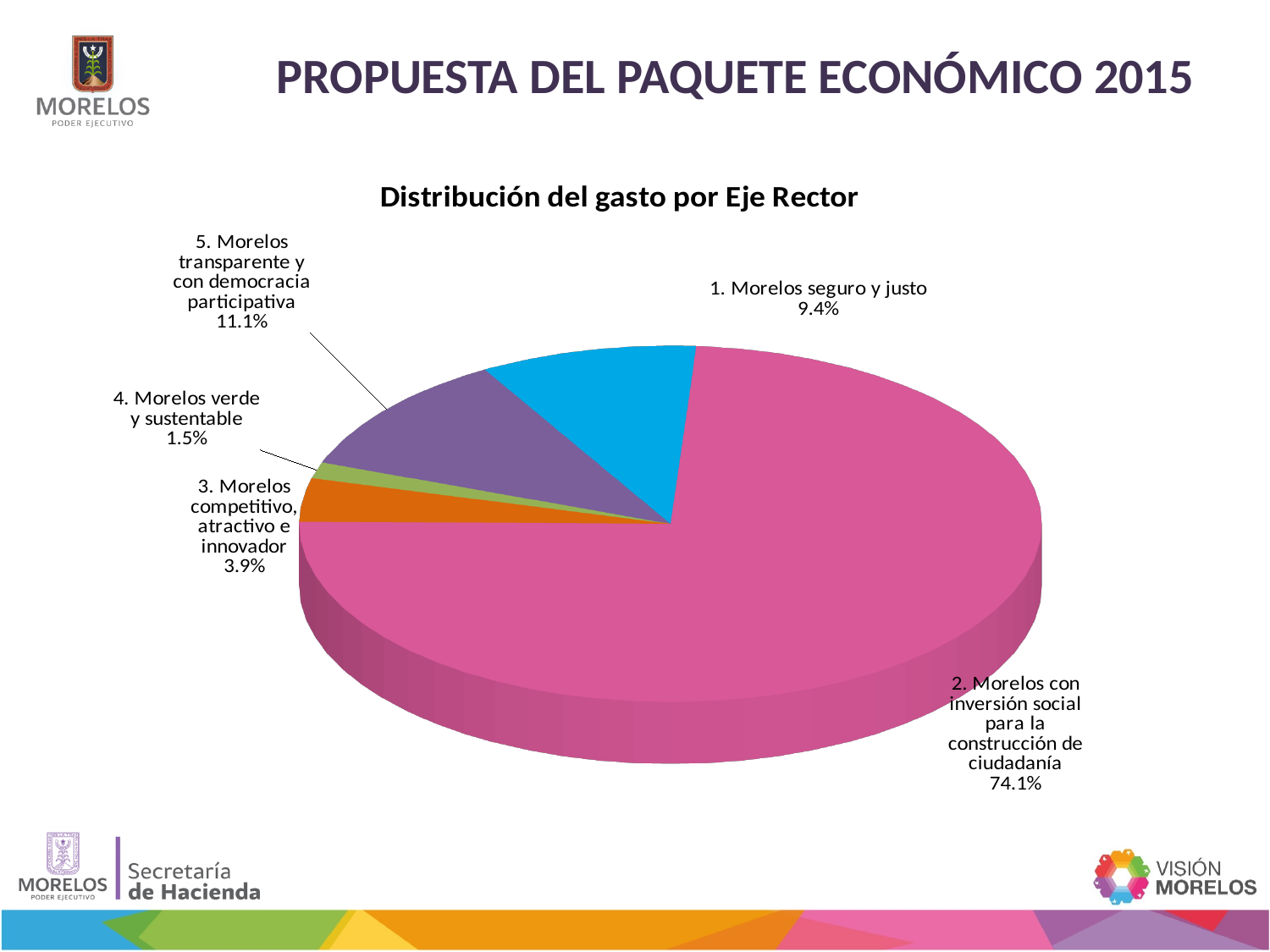
How many categories are shown in the pie chart? 5 What share of the pie does '2. Morelos con inversión social para la construcción de ciudadanía' represent? 74.1% What is the value shown for '3. Morelos competitivo, atractivo e innovador'? 3.9% What is the value shown for '4. Morelos verde y sustentable'? 1.5% What is the title of the chart? Distribución del gasto por Eje Rector What is the value shown for '5. Morelos transparente y con democracia participativa'? 11.1% Which category has the smallest slice of the pie? 4. Morelos verde y sustentable What is the value shown for '1. Morelos seguro y justo'? 9.4% What kind of chart is shown on the slide? Pie chart What is the difference between the values for '5. Morelos transparente y con democracia participativa' and '1. Morelos seguro y justo'? 1.7% Which is larger: the value for '3. Morelos competitivo, atractivo e innovador' or '4. Morelos verde y sustentable'? 3. Morelos competitivo, atractivo e innovador Which category has the largest slice of the pie? 2. Morelos con inversión social para la construcción de ciudadanía